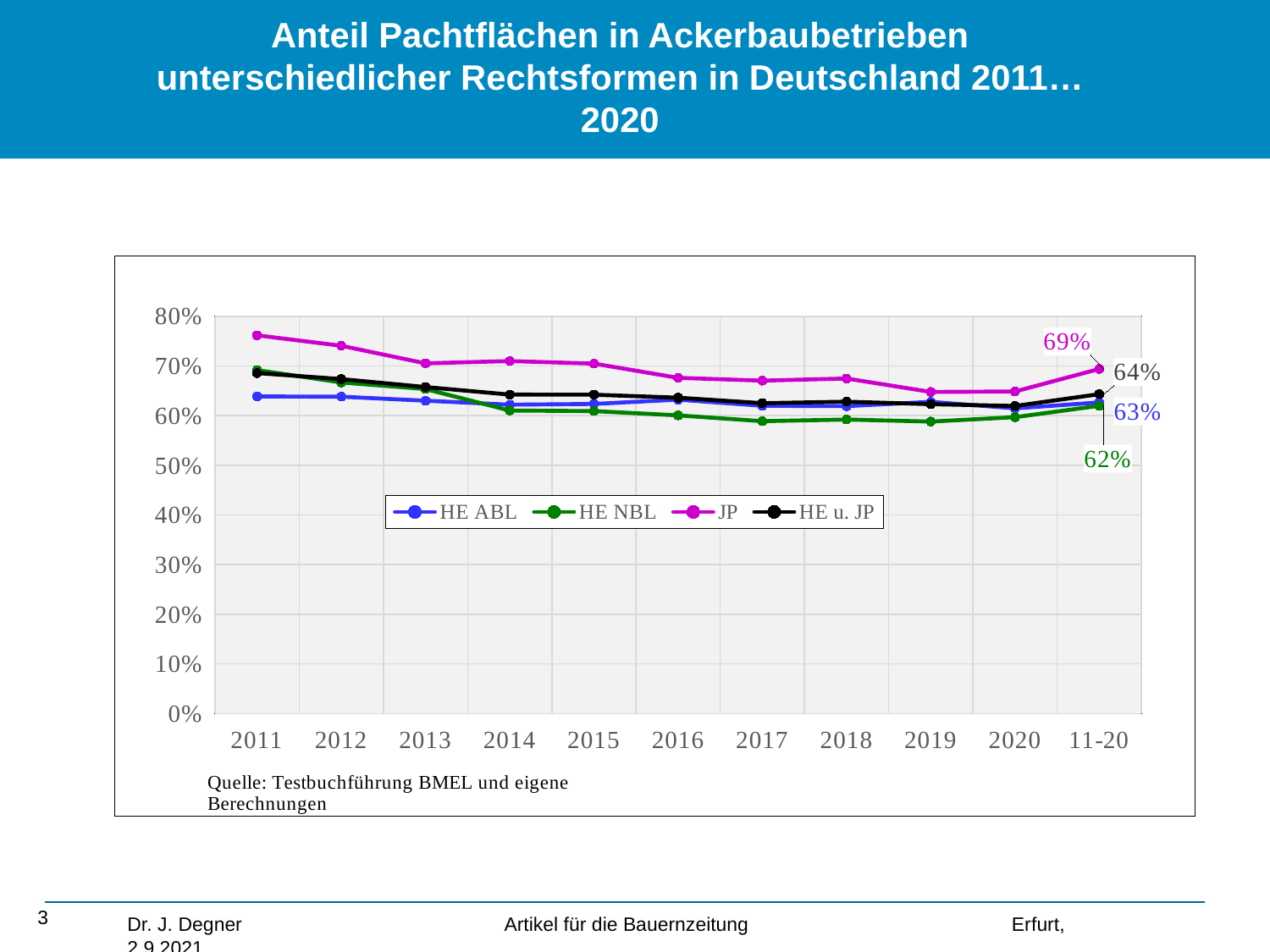
What is the value for HE u. JP at 11-20? 64% What kind of chart is shown on the slide? line chart What is the value for JP at 11-20? 69% How many series does the legend list? 4 How many categories are shown on the x axis? 11 What is the value for HE ABL at 11-20? 63% Is the value for JP in 2011 greater or less than 70%? greater Which series has the lowest value at 11-20? HE NBL Does the JP series rise or fall from 2011 to 2020? fall Which series has the highest value at 11-20? JP What is the difference between the JP value and the HE NBL value at 11-20? 7 percentage points What is the value for HE NBL at 11-20? 62%